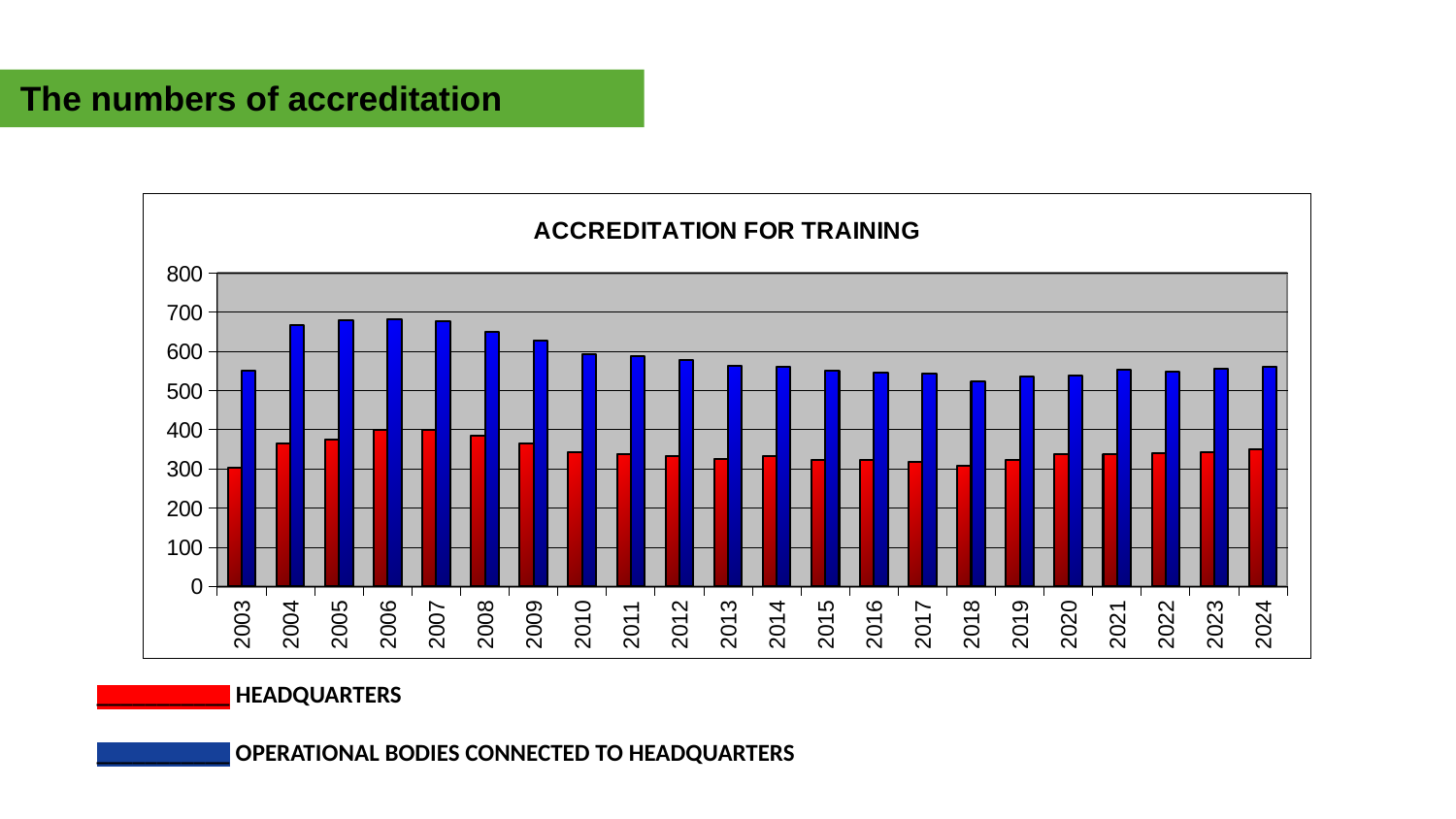
Is the value for OPERATIONAL BODIES CONNECTED TO HEADQUARTERS in 2006 greater or less than 600? greater What is the title of the chart? ACCREDITATION FOR TRAINING Is the value for HEADQUARTERS in 2017 greater or less than 400? less Which series is shown in blue? OPERATIONAL BODIES CONNECTED TO HEADQUARTERS Is the value for HEADQUARTERS in 2006 greater or less than 300? greater What kind of chart is shown on the slide? Bar chart In 2010, which series has the larger value: HEADQUARTERS or OPERATIONAL BODIES CONNECTED TO HEADQUARTERS? OPERATIONAL BODIES CONNECTED TO HEADQUARTERS How many series does the legend list? 2 Which is larger for OPERATIONAL BODIES CONNECTED TO HEADQUARTERS: the value in 2006 or the value in 2003? 2006 How many years are shown on the x axis of the chart? 22 Do the values for OPERATIONAL BODIES CONNECTED TO HEADQUARTERS rise or fall from 2006 to 2018? fall